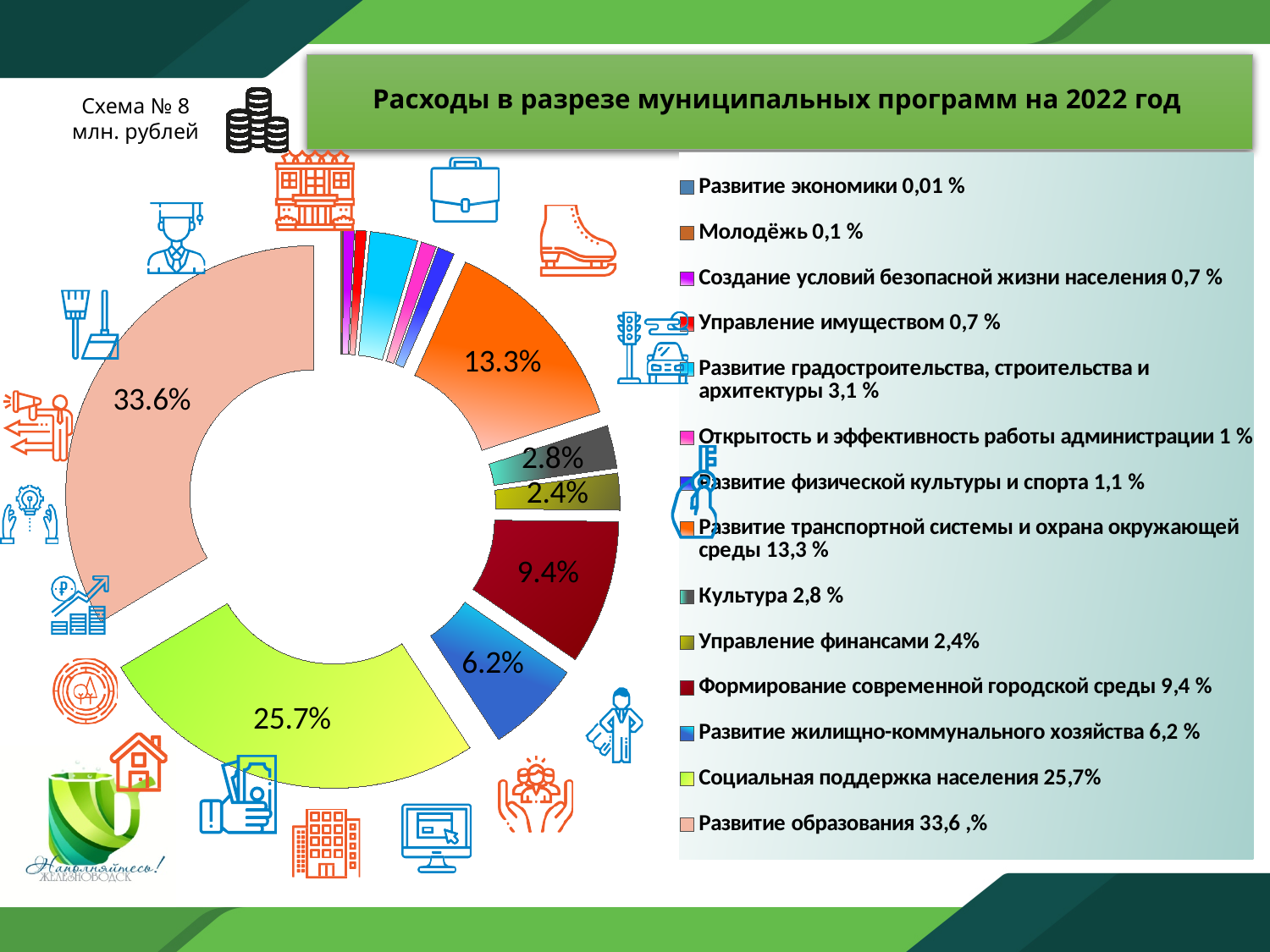
What kind of chart is shown on the slide? doughnut chart Which slice is larger: Формирование современной городской среды or Развитие жилищно-коммунального хозяйства? Формирование современной городской среды What share of the pie chart is labelled for Развитие транспортной системы и охрана окружающей среды? 13.3% What share of the pie chart is labelled for Управление финансами? 2.4% According to the legend, which category has the smallest share? Развитие экономики What is the title of the chart on the slide? Расходы в разрезе муниципальных программ на 2022 год Which category has the largest slice of the pie chart? Развитие образования What share of the pie chart is labelled for Социальная поддержка населения? 25.7% What is the difference in percentage points between the slices for Развитие образования (33.6%) and Социальная поддержка населения (25.7%)? 7.9 What share of the pie chart is labelled for Культура? 2.8% What share of the pie chart is labelled for Развитие образования? 33.6% How many categories does the legend of the pie chart list? 14